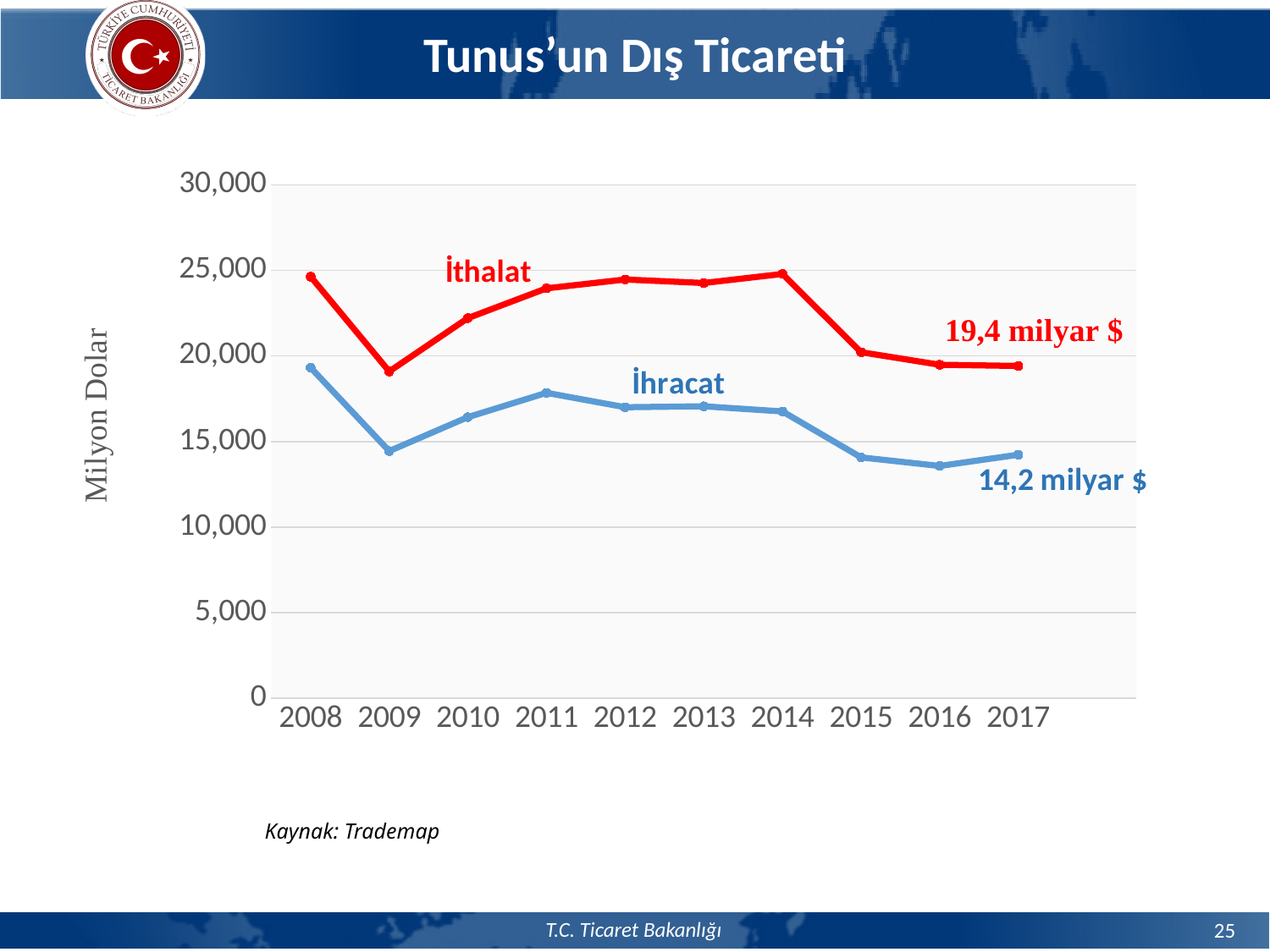
How many series are plotted on the chart? 2 Is the value for İthalat in 2008 greater or less than 20,000? greater What kind of chart is shown on the slide? line chart How many years are shown on the x axis of the chart? 10 What is the difference between the labelled 2017 values of İthalat and İhracat? 5,2 milyar $ Is the value for İhracat in 2016 greater or less than 15,000? less Does İthalat rise or fall from 2014 to 2017? fall What is the label on the vertical axis of the chart? Milyon Dolar What is the labelled value of İhracat in 2017? 14,2 milyar $ What is the labelled value of İthalat in 2017? 19,4 milyar $ Which series is higher in 2017, İthalat or İhracat? İthalat In which year is İhracat at its highest? 2008